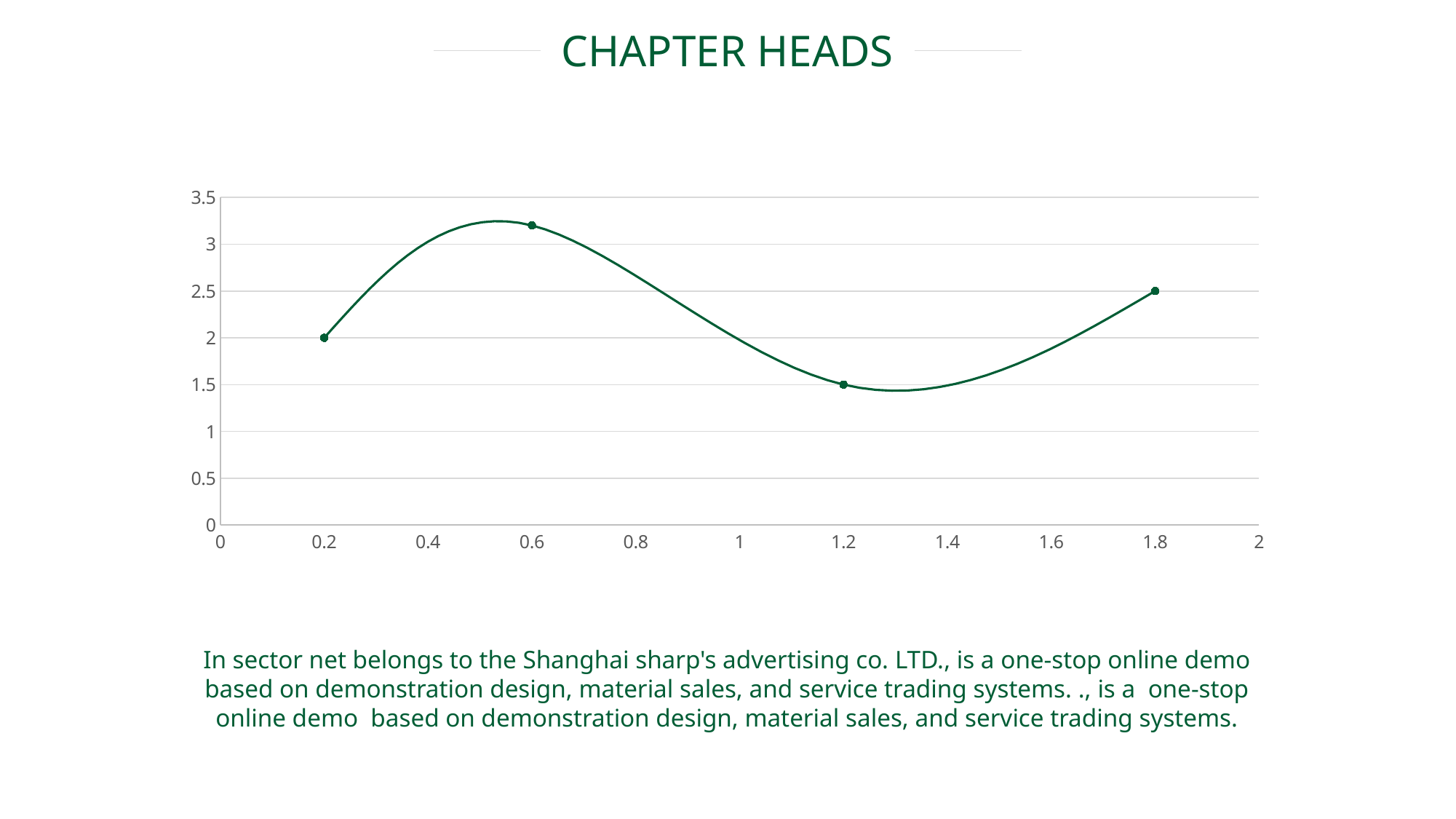
What kind of chart is shown on the slide? line chart What is the y value of the point at x = 1.8? 2.5 Which point has the larger y value, the one at x = 0.2 or the one at x = 1.8? x = 1.8 What is the y value of the point at x = 0.2? 2 Between x = 0.6 and x = 1.2, does the line rise or fall? fall What is the y value of the point at x = 1.2? 1.5 What is the difference between the y values at x = 1.8 and x = 1.2? 1 How many data points are plotted on the line? 4 At which x value does the line reach its highest plotted point? 0.6 At which x value does the line reach its lowest plotted point? 1.2 What is the difference between the y values at x = 1.8 and x = 0.2? 0.5 Is the y value of the point at x = 0.6 greater or less than 3? greater